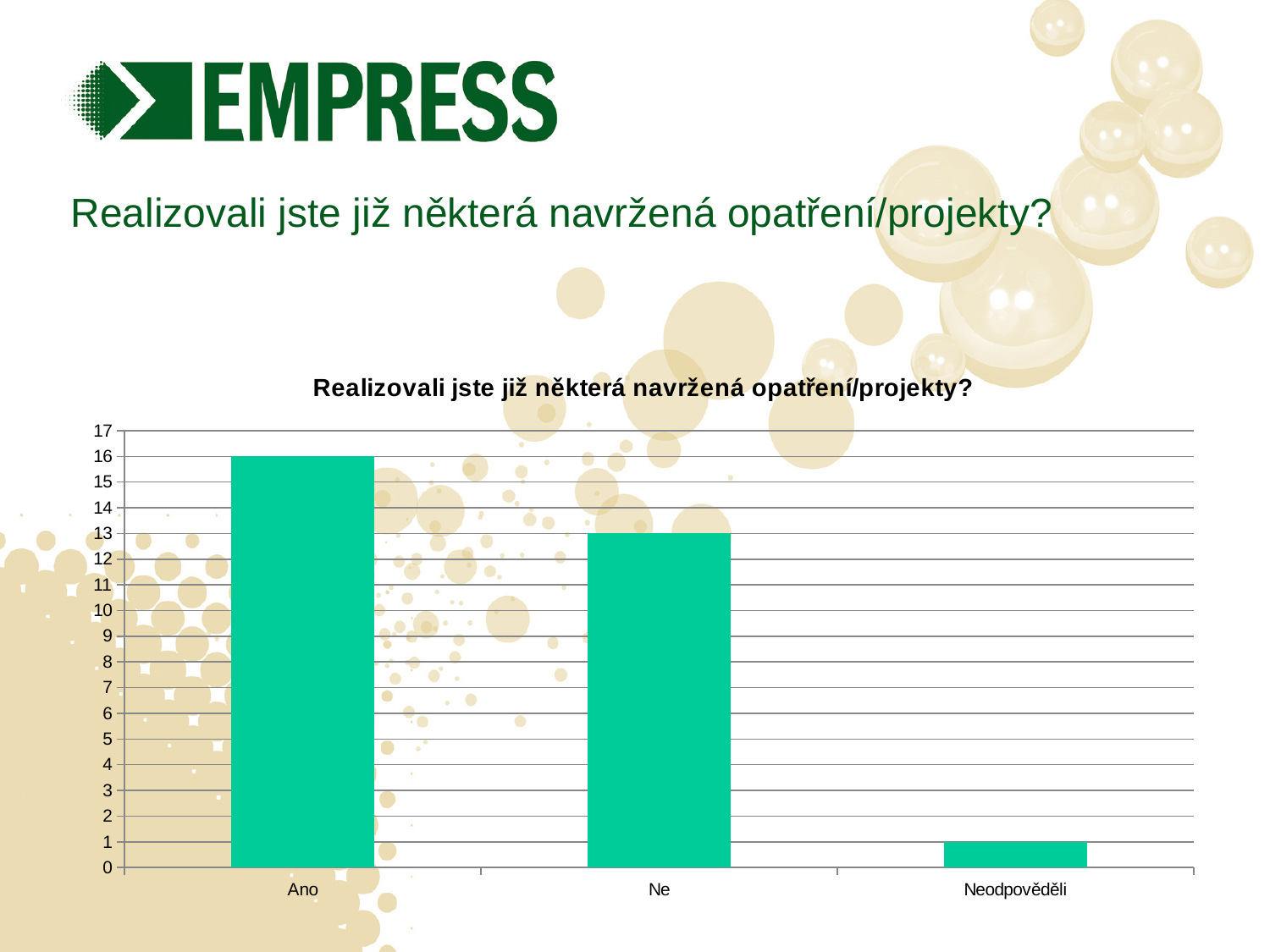
What is the value for Ano? 16 What is the difference between the values for Ne and Neodpověděli? 12 What is the value for Neodpověděli? 1 Is the value for Ne greater or less than 10? greater Which category has the highest value? Ano What is the title of the chart? Realizovali jste již některá navržená opatření/projekty? Which category has the lowest value? Neodpověděli What is the value for Ne? 13 What is the difference between the values for Ano and Ne? 3 How many categories are shown on the x axis? 3 What kind of chart is shown on the slide? bar chart Which is larger, the value for Ano or the value for Ne? Ano